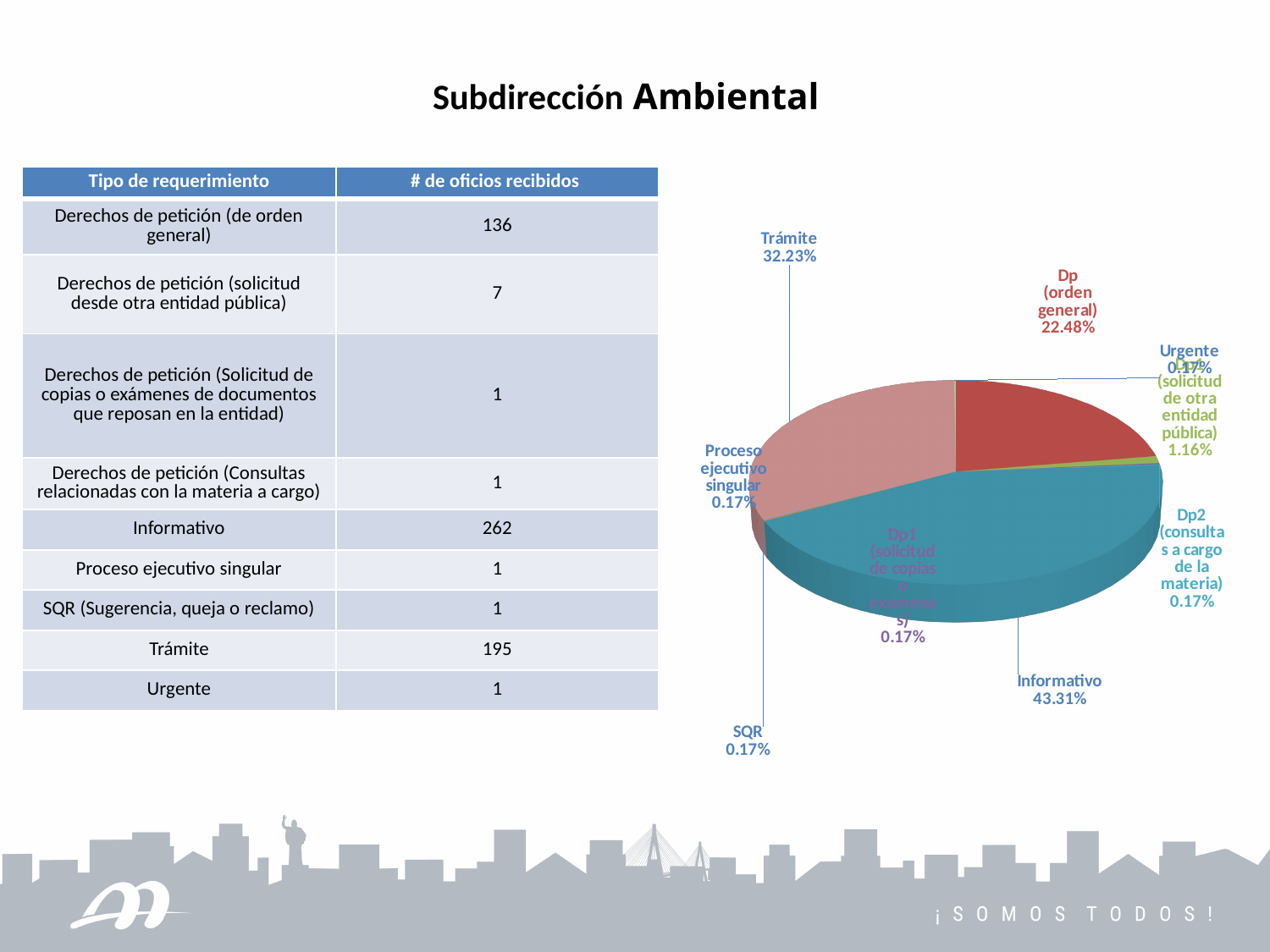
What is the difference in percentage points between Informativo and Trámite in the pie chart? 11.08% What share of the pie does Trámite represent? 32.23% What kind of chart is shown on the slide? pie chart Which slice of the pie chart is the largest? Informativo What percentage is shown for Proceso ejecutivo singular in the pie chart? 0.17% What percentage is shown for Dp (orden general) in the pie chart? 22.48% How many slices does the pie chart have? 9 What is the title of the slide containing the pie chart? Subdirección Ambiental What percentage is shown for SQR in the pie chart? 0.17% What is the difference in percentage points between Trámite and Dp (orden general) in the pie chart? 9.75% What share of the pie does Informativo represent? 43.31% Which is larger in the pie chart, Trámite or Dp (orden general)? Trámite